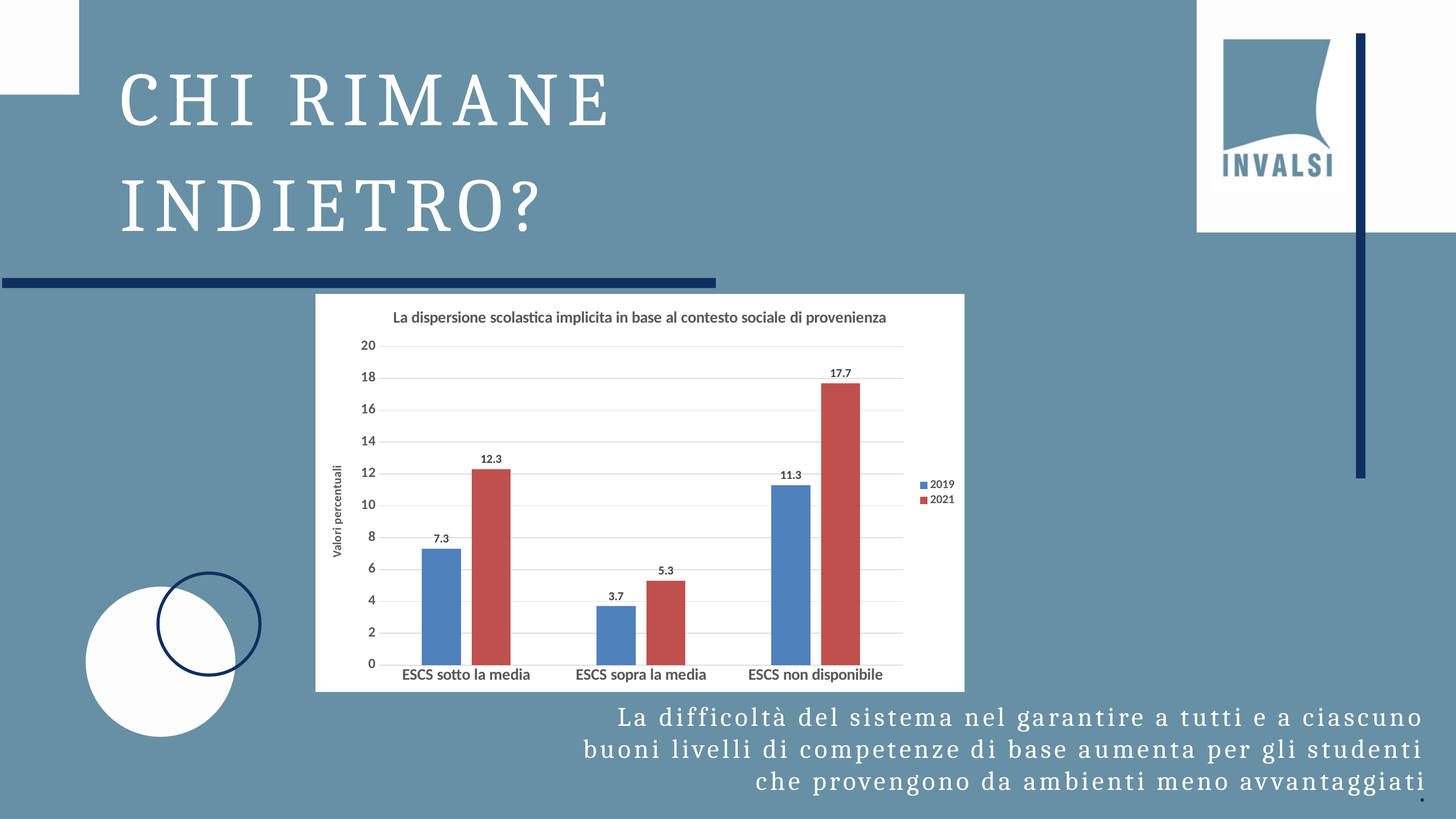
What is the title of the chart? La dispersione scolastica implicita in base al contesto sociale di provenienza Which is larger: the 2021 value for ESCS sopra la media or the 2019 value for ESCS sotto la media? 2019 value for ESCS sotto la media Which category has the highest 2021 value? ESCS non disponibile How many categories are shown on the x axis? 3 What is the 2019 value for ESCS sopra la media? 3.7 What is the difference between the 2021 and 2019 values for ESCS non disponibile? 6.4 What is the difference between the 2021 and 2019 values for ESCS sotto la media? 5.0 What is the 2021 value for ESCS sotto la media? 12.3 Which category has the lowest 2019 value? ESCS sopra la media What kind of chart is shown on the slide? Bar chart How many series does the legend list? 2 What is the 2019 value for ESCS non disponibile? 11.3